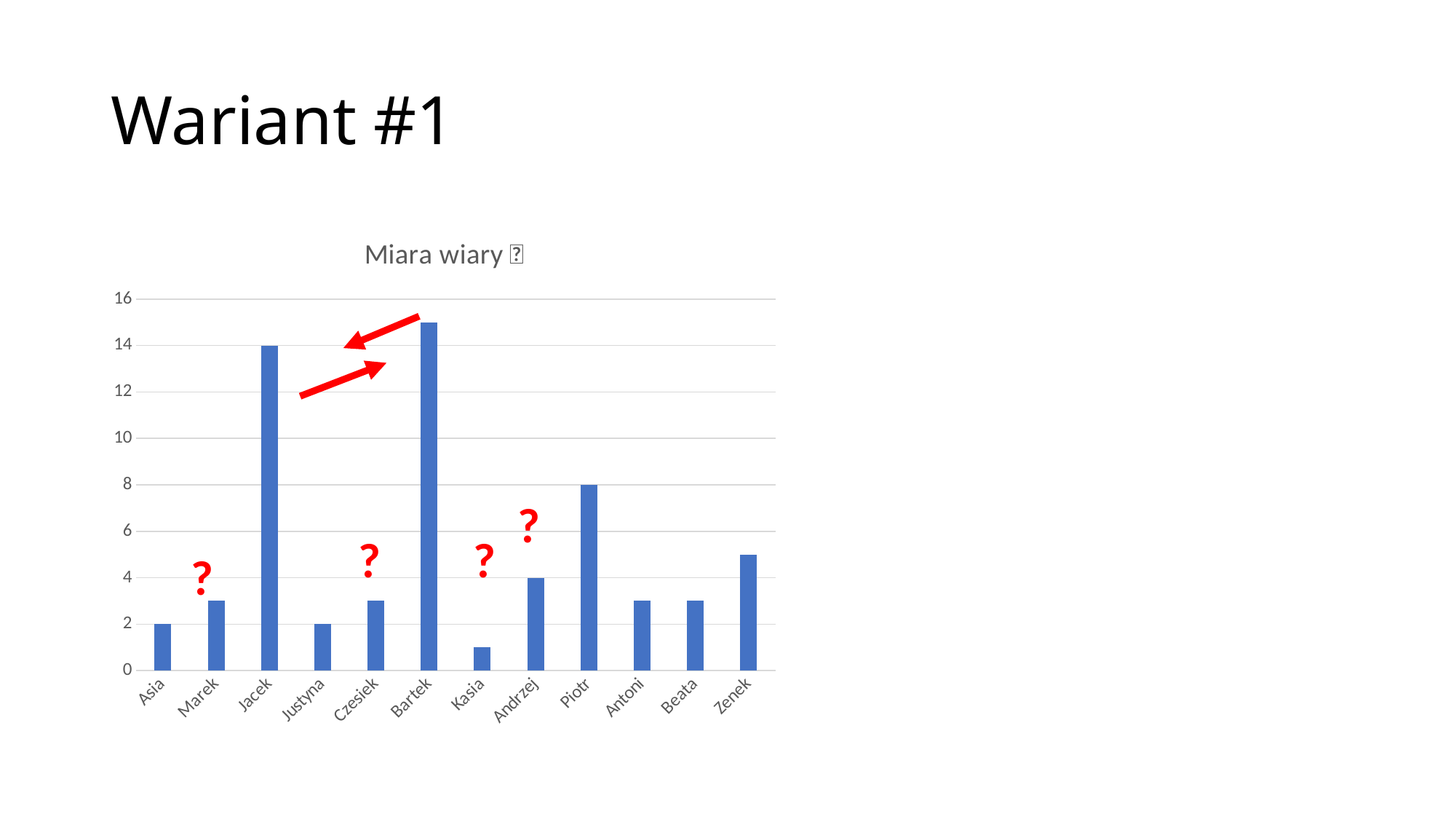
How many categories (people) are shown on the x axis of the chart? 12 Which person has the highest bar in the chart? Bartek Which person has the lowest bar in the chart? Kasia Is the value for Zenek greater or less than 4? greater What is the value for Andrzej? 4 What is the value for Piotr? 8 What type of chart is shown on the slide? bar chart What is the value for Jacek? 14 What is the value for Asia? 2 Which is larger, the value for Piotr or the value for Zenek? Piotr What is the difference between the values for Piotr and Andrzej? 4 Is the value for Bartek greater or less than 14? greater